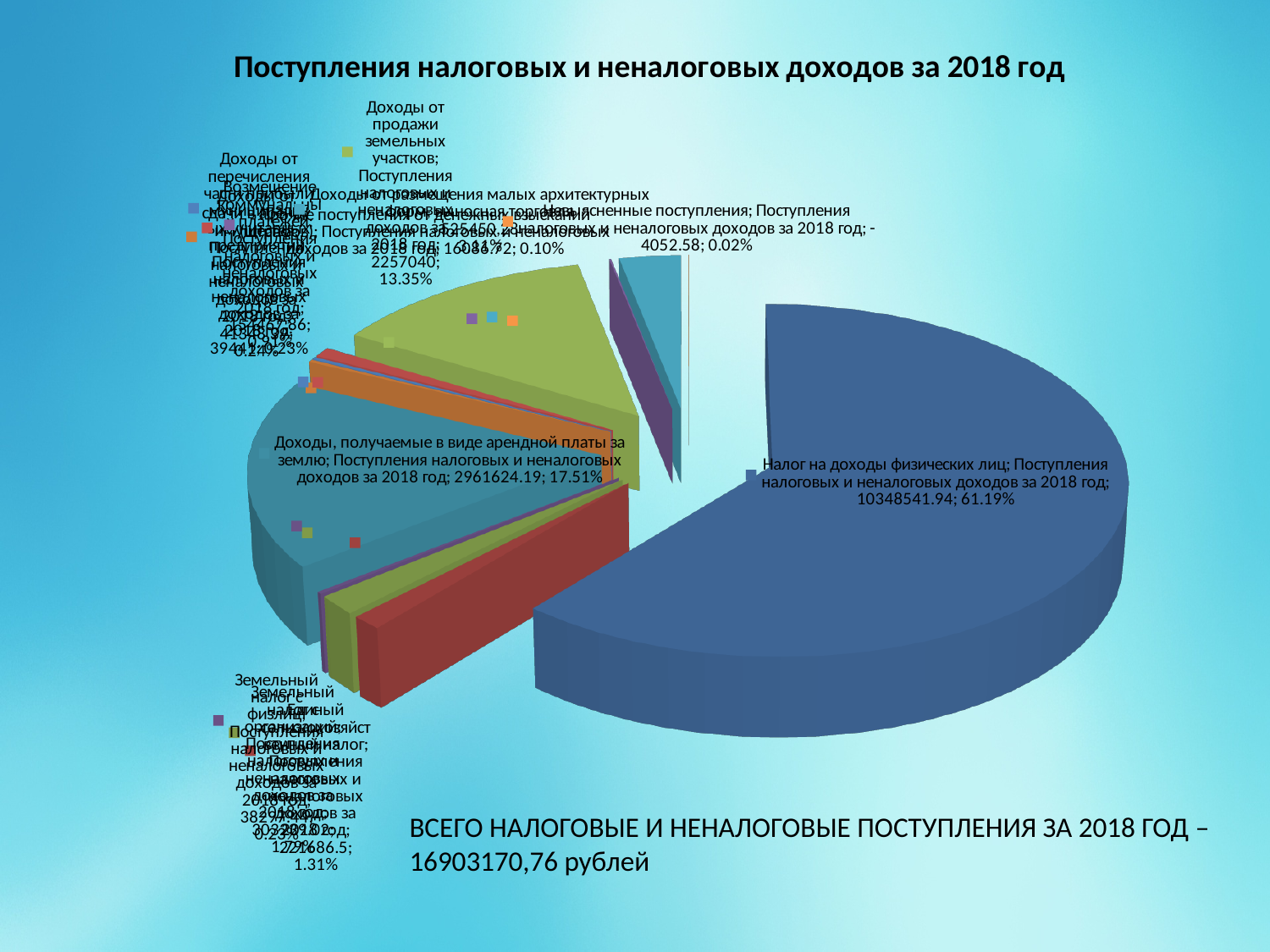
What is the value shown for 'Доходы, получаемые в виде арендной платы за землю'? 2961624.19 What type of chart is shown on the slide? pie chart What is the value shown for 'Доходы от продажи земельных участков'? 2257040 What share of the pie does 'Налог на доходы физических лиц' represent? 61.19% According to the text on the slide, what is the total of tax and non-tax receipts for 2018? 16903170,76 рублей Which is larger: 'Доходы, получаемые в виде арендной платы за землю' or 'Доходы от продажи земельных участков'? Доходы, получаемые в виде арендной платы за землю What is the title of the chart? Поступления налоговых и неналоговых доходов за 2018 год What is the value shown for 'Налог на доходы физических лиц'? 10348541.94 What is the difference in percentage share between 'Налог на доходы физических лиц' and 'Доходы, получаемые в виде арендной платы за землю'? 43.68% What share of the pie does 'Доходы от продажи земельных участков' represent? 13.35% What share of the pie does 'Доходы, получаемые в виде арендной платы за землю' represent? 17.51% Which category has the largest slice of the pie? Налог на доходы физических лиц